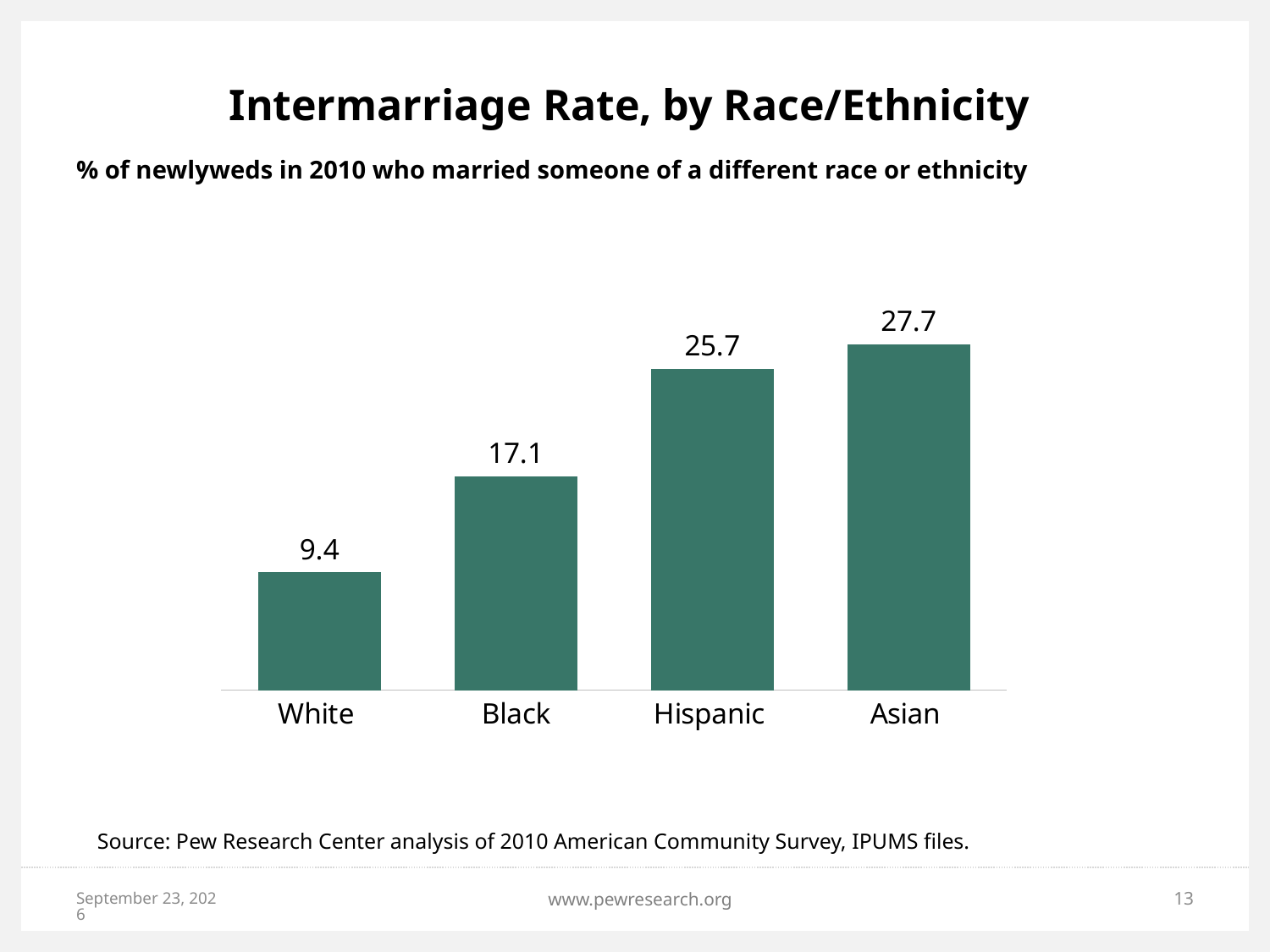
What is the intermarriage rate for Hispanic newlyweds? 25.7 How many race/ethnicity categories are shown in the chart? 4 What is the intermarriage rate for White newlyweds? 9.4 Which race/ethnicity has the lowest intermarriage rate? White What is the intermarriage rate for Black newlyweds? 17.1 Which has a higher intermarriage rate, Black or Hispanic newlyweds? Hispanic What is the title of the chart? Intermarriage Rate, by Race/Ethnicity What is the difference between the intermarriage rates for Black and White newlyweds? 7.7 What kind of chart is shown on the slide? Bar chart Which race/ethnicity has the highest intermarriage rate? Asian What is the difference between the intermarriage rates for Asian and White newlyweds? 18.3 Do the values rise or fall moving from White to Asian along the x axis? Rise